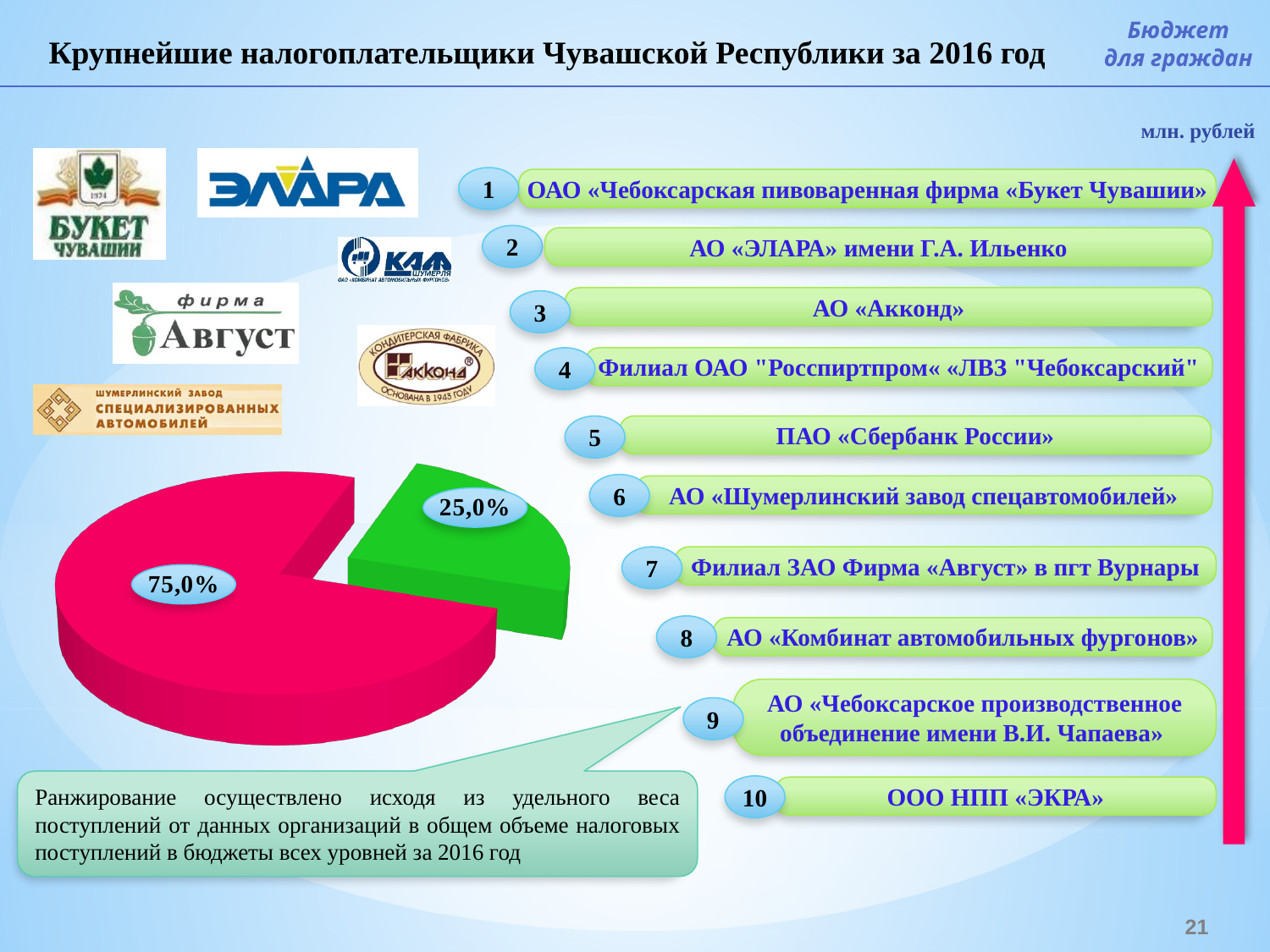
What colour is the slice labelled 25,0% in the pie chart? green What share of the pie does the green slice represent? 25,0% What value is labelled on the pink slice of the pie chart? 75,0% What kind of chart is shown on the slide? pie chart Which slice of the pie chart is the largest? the pink slice (75,0%) What value is labelled on the green slice of the pie chart? 25,0% How many slices does the pie chart have? 2 What is the total of the two slices shown in the pie chart? 100,0% Which is larger in the pie chart, the green slice or the pink slice? the pink slice What is the difference between the pink slice and the green slice of the pie chart? 50,0% Which slice of the pie chart is the smallest? the green slice (25,0%) What unit is indicated at the top right of the slide next to the arrow? млн. рублей